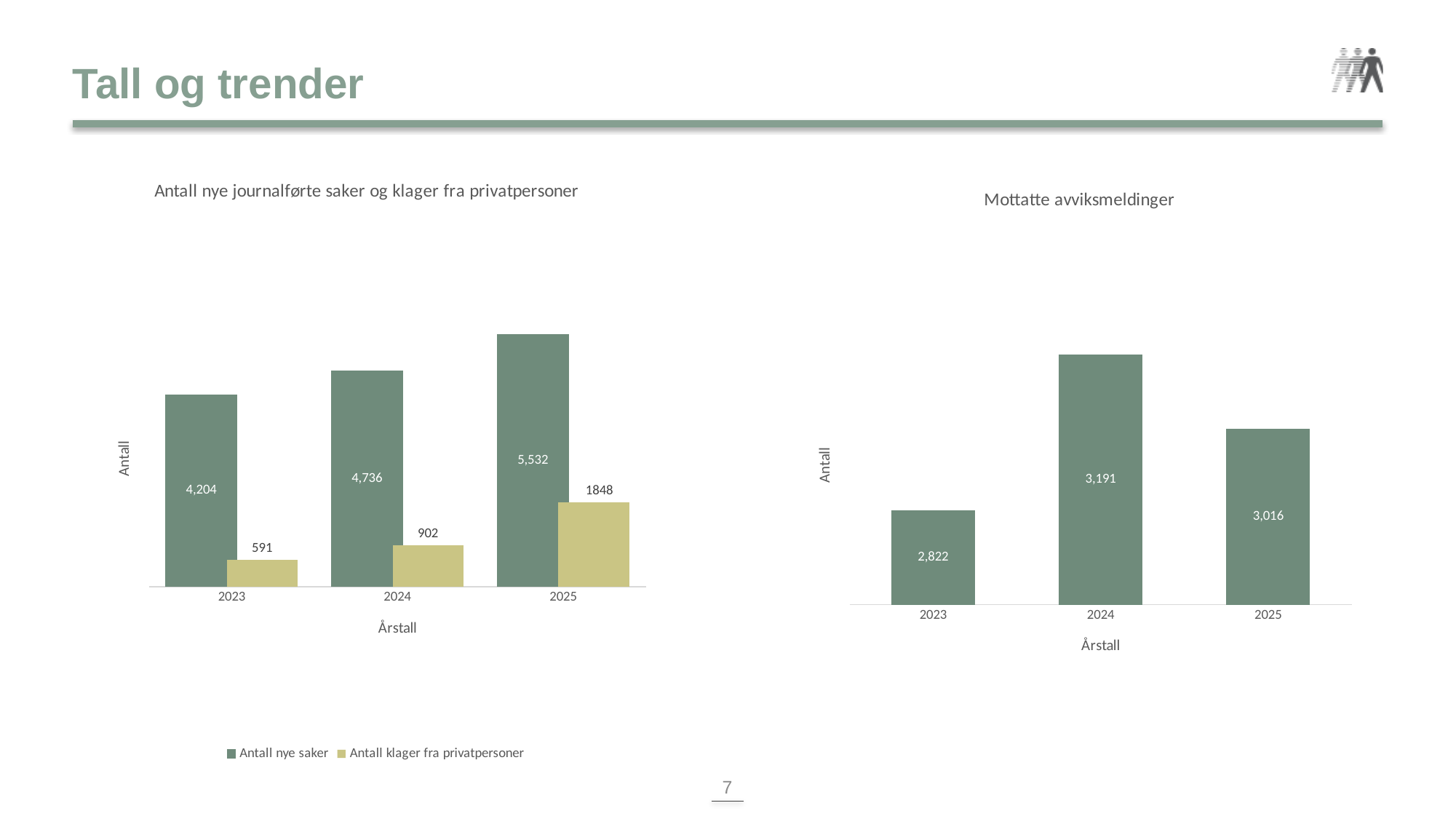
In the chart 'Antall nye journalførte saker og klager fra privatpersoner', what is the value for Antall nye saker in 2024? 4,736 In the chart 'Antall nye journalførte saker og klager fra privatpersoner', how many series does the legend list? 2 In the chart 'Antall nye journalførte saker og klager fra privatpersoner', what is the value for Antall klager fra privatpersoner in 2025? 1848 In the chart 'Antall nye journalførte saker og klager fra privatpersoner', which colour represents Antall klager fra privatpersoner? yellow-green In the chart 'Mottatte avviksmeldinger', what is the value for 2023? 2,822 In the chart 'Antall nye journalførte saker og klager fra privatpersoner', do the values for Antall nye saker rise or fall from 2023 to 2025? rise In the chart 'Mottatte avviksmeldinger', which year has the highest value? 2024 In the chart 'Mottatte avviksmeldinger', how many years are shown on the x axis? 3 What kind of chart is 'Mottatte avviksmeldinger'? bar chart In the chart 'Antall nye journalførte saker og klager fra privatpersoner', what is the difference between Antall nye saker in 2025 and in 2023? 1,328 In the chart 'Antall nye journalførte saker og klager fra privatpersoner', which year has the lowest value for Antall klager fra privatpersoner? 2023 In the chart 'Mottatte avviksmeldinger', what is the difference between the values for 2024 and 2025? 175